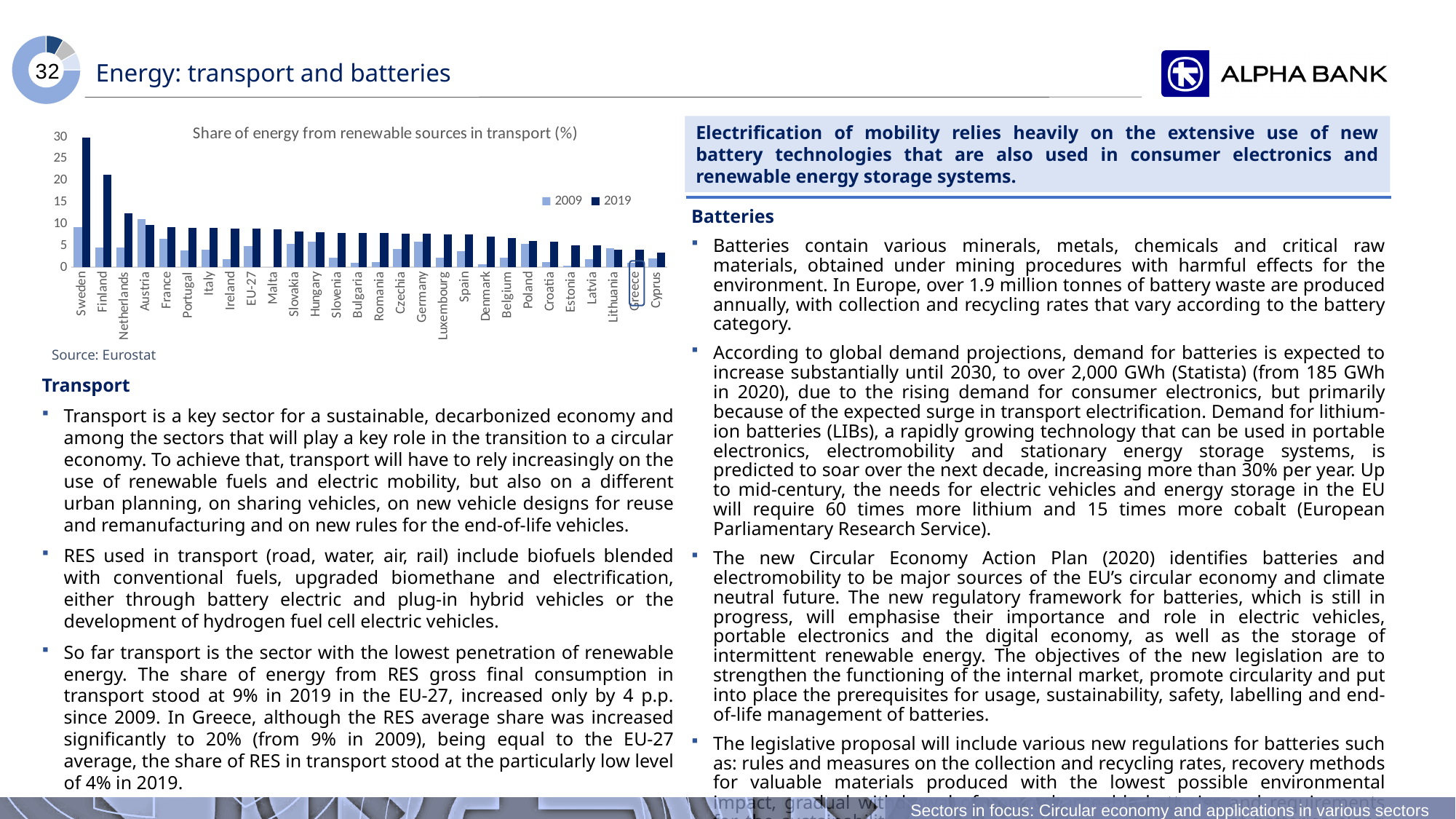
Is the 2019 value for Sweden greater or less than 25? greater Do the 2019 values rise or fall moving from left to right along the x axis? Fall Which country has the lowest share of renewable energy in transport in 2019? Cyprus Is the 2019 value for Finland greater or less than 20? greater What is the source cited below the chart? Eurostat Is the 2019 value for Greece greater or less than 5? less What kind of chart is shown on the slide? Bar chart Which country has the highest share of renewable energy in transport in 2019? Sweden How many countries/regions are shown on the x axis of the chart? 28 What is the title of the chart? Share of energy from renewable sources in transport (%) How many series does the chart legend list? 2 Which is larger for Finland: the 2009 value or the 2019 value? 2019